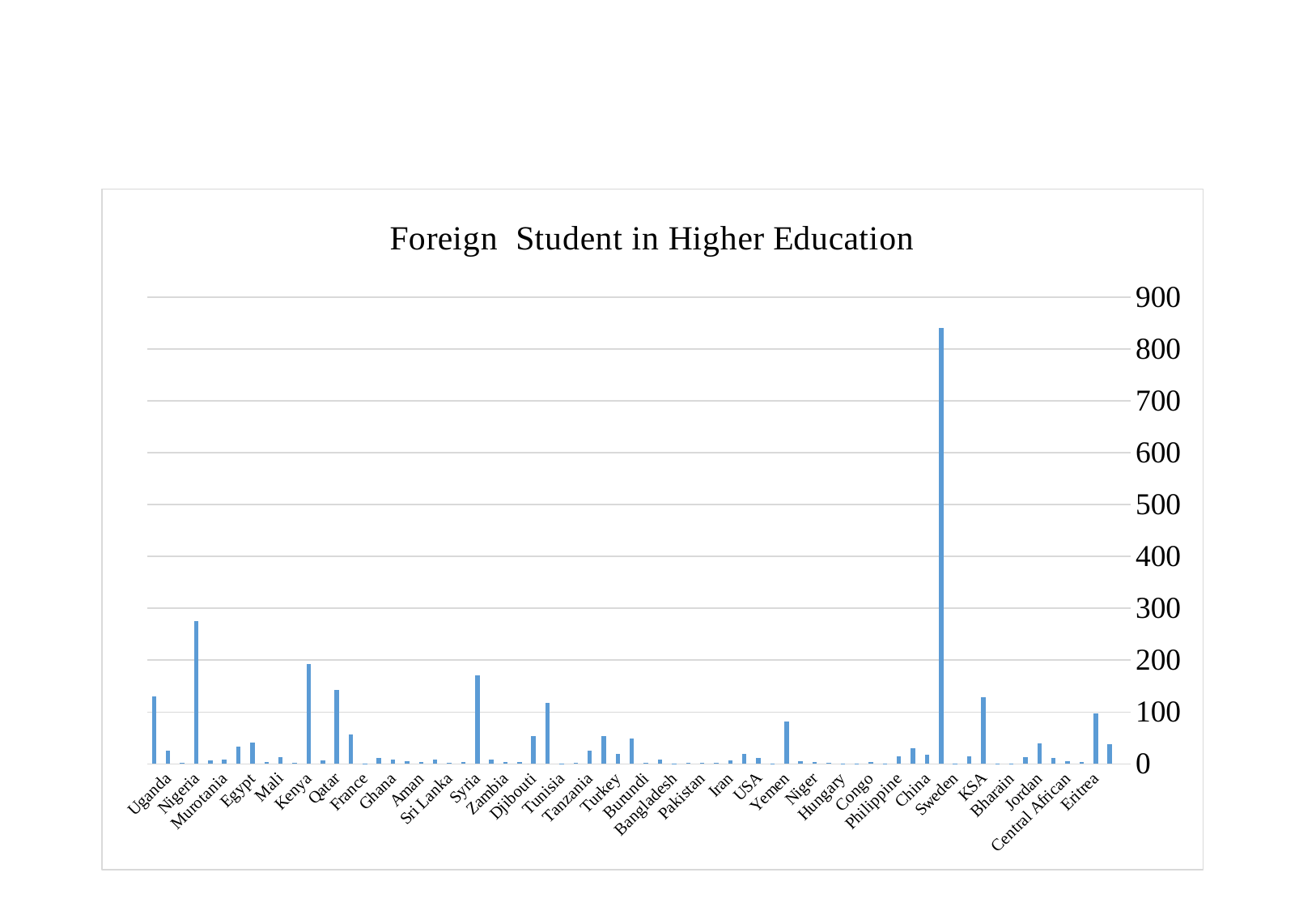
What is the title of the chart? Foreign Student in Higher Education Is the value for Syria greater or less than 100? greater Which has a higher value, Nigeria or Kenya? Nigeria What is the highest value shown on the vertical axis? 900 What kind of chart is shown on the slide? bar chart Which has a higher value, Uganda or Yemen? Yemen Which has a higher value, Syria or KSA? Syria Is the value for Kenya greater or less than 100? greater Is the value for Qatar greater or less than 100? greater